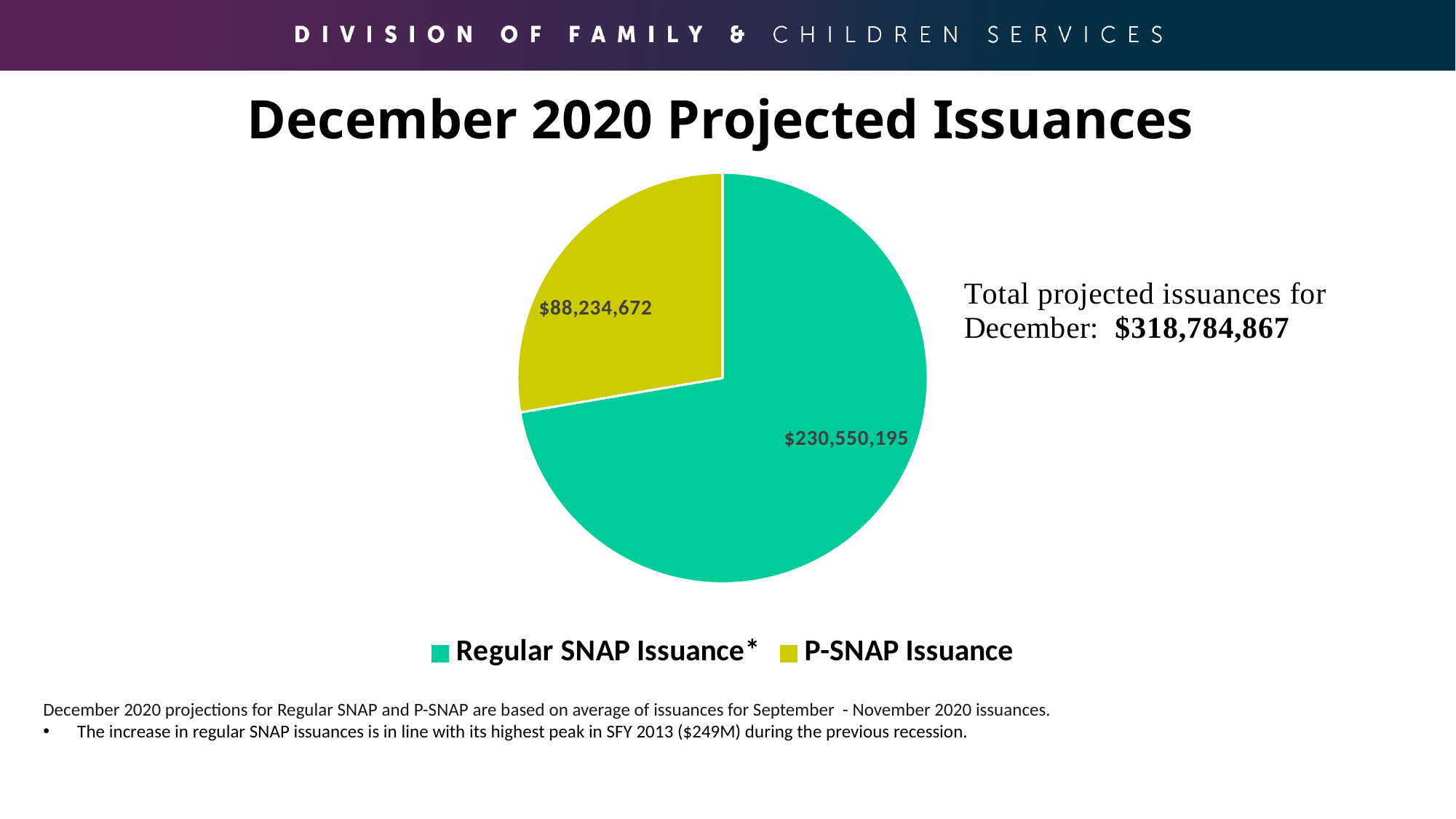
What is the value of the P-SNAP Issuance slice in the pie chart? $88,234,672 What colour is the P-SNAP Issuance slice? Yellow-green How many slices does the pie chart have? 2 What is the title of the slide containing the pie chart? December 2020 Projected Issuances Which slice of the pie chart is the largest? Regular SNAP Issuance* How many entries does the legend list? 2 What is the total of the two slices in the pie chart? $318,784,867 What is the difference between the Regular SNAP Issuance* value and the P-SNAP Issuance value? $142,315,523 What kind of chart is shown on the slide? Pie chart What is the value of the Regular SNAP Issuance* slice in the pie chart? $230,550,195 Which is larger, Regular SNAP Issuance* or P-SNAP Issuance? Regular SNAP Issuance* Which slice of the pie chart is the smallest? P-SNAP Issuance